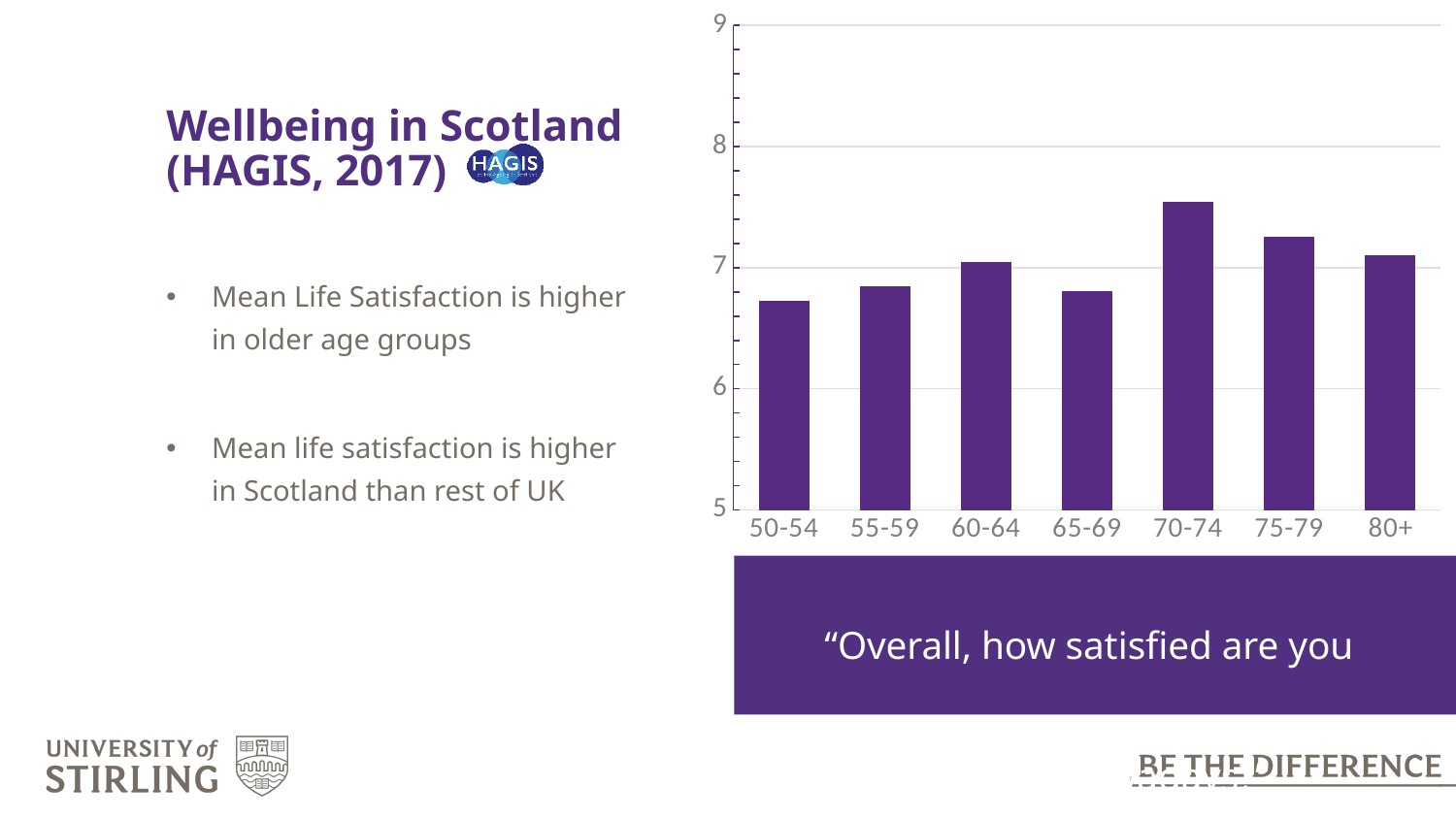
Is the value for the 70-74 age group greater or less than 8? less How many age groups are shown on the x axis of the chart? 7 Which age group has the highest bar in the chart? 70-74 Which has the larger value, the 70-74 age group or the 75-79 age group? 70-74 Which has the larger value, the 55-59 age group or the 75-79 age group? 75-79 What is the highest value shown on the y axis of the chart? 9 Is the value for the 70-74 age group greater or less than 7? greater Is the value for the 50-54 age group greater or less than 7? less What is the lowest value shown on the y axis of the chart? 5 What kind of chart is shown on the slide? bar chart